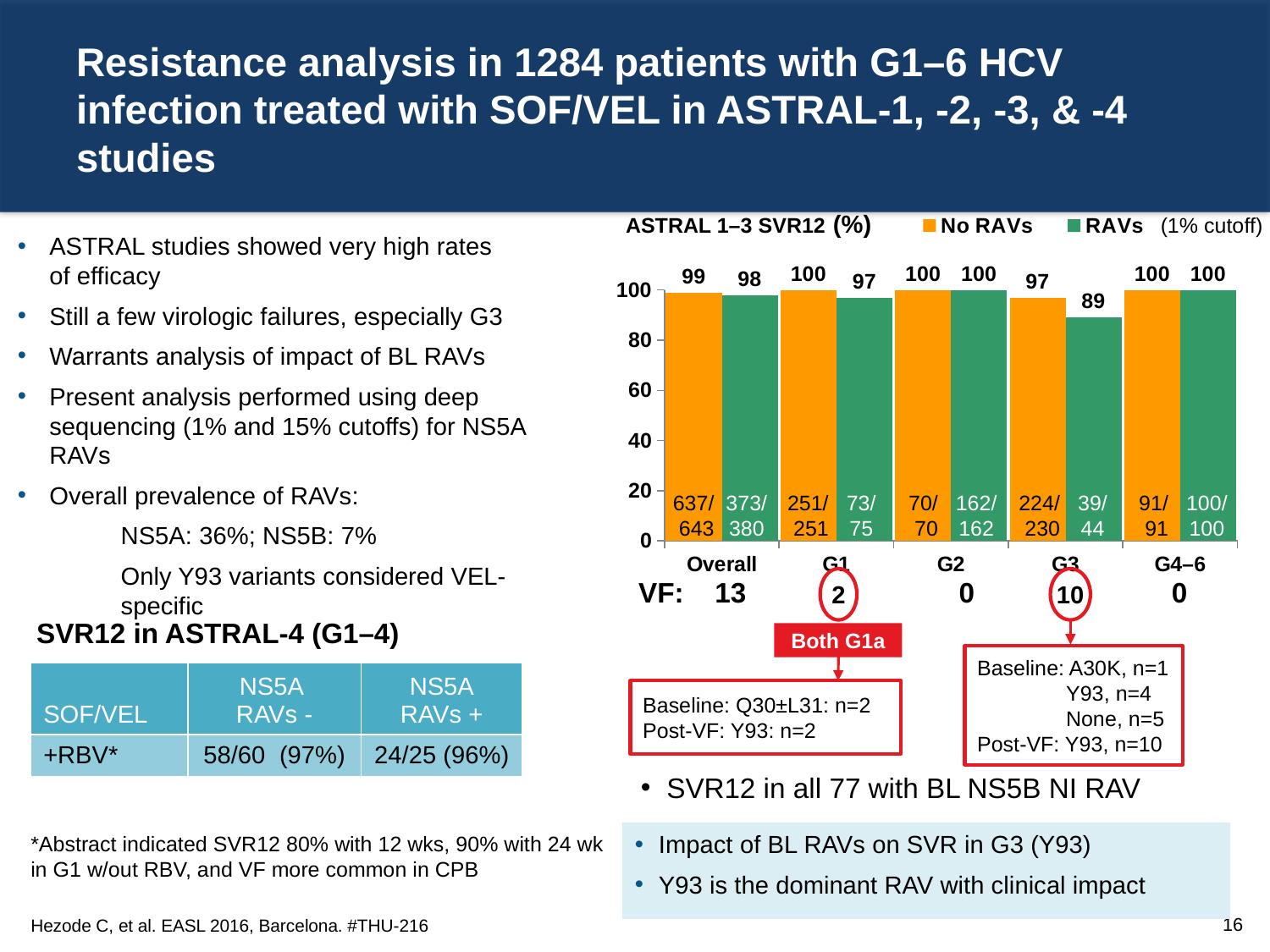
In the ASTRAL 1–3 SVR12 (%) chart, is the RAVs value for G3 greater or less than 80? greater What kind of chart is the ASTRAL 1–3 SVR12 (%) chart? bar chart In the ASTRAL 1–3 SVR12 (%) chart, what is the SVR12 value for the RAVs series in G1? 97 In the ASTRAL 1–3 SVR12 (%) chart, which category has the lowest SVR12 value for the RAVs series? G3 In the ASTRAL 1–3 SVR12 (%) chart, what is the difference between the No RAVs and RAVs SVR12 values in G3? 8 How many series does the legend of the ASTRAL 1–3 SVR12 (%) chart list? 2 In the ASTRAL 1–3 SVR12 (%) chart, what is the SVR12 value for the No RAVs series in the Overall category? 99 How many categories are shown on the x axis of the ASTRAL 1–3 SVR12 (%) chart? 5 In the ASTRAL 1–3 SVR12 (%) chart, what is the SVR12 value for the RAVs series in G3? 89 In the ASTRAL 1–3 SVR12 (%) chart, which is larger in G1: the No RAVs value or the RAVs value? No RAVs In the ASTRAL 1–3 SVR12 (%) chart, what is the difference between the No RAVs and RAVs SVR12 values in the Overall category? 1 In the ASTRAL 1–3 SVR12 (%) chart, what colour represents the RAVs series? green